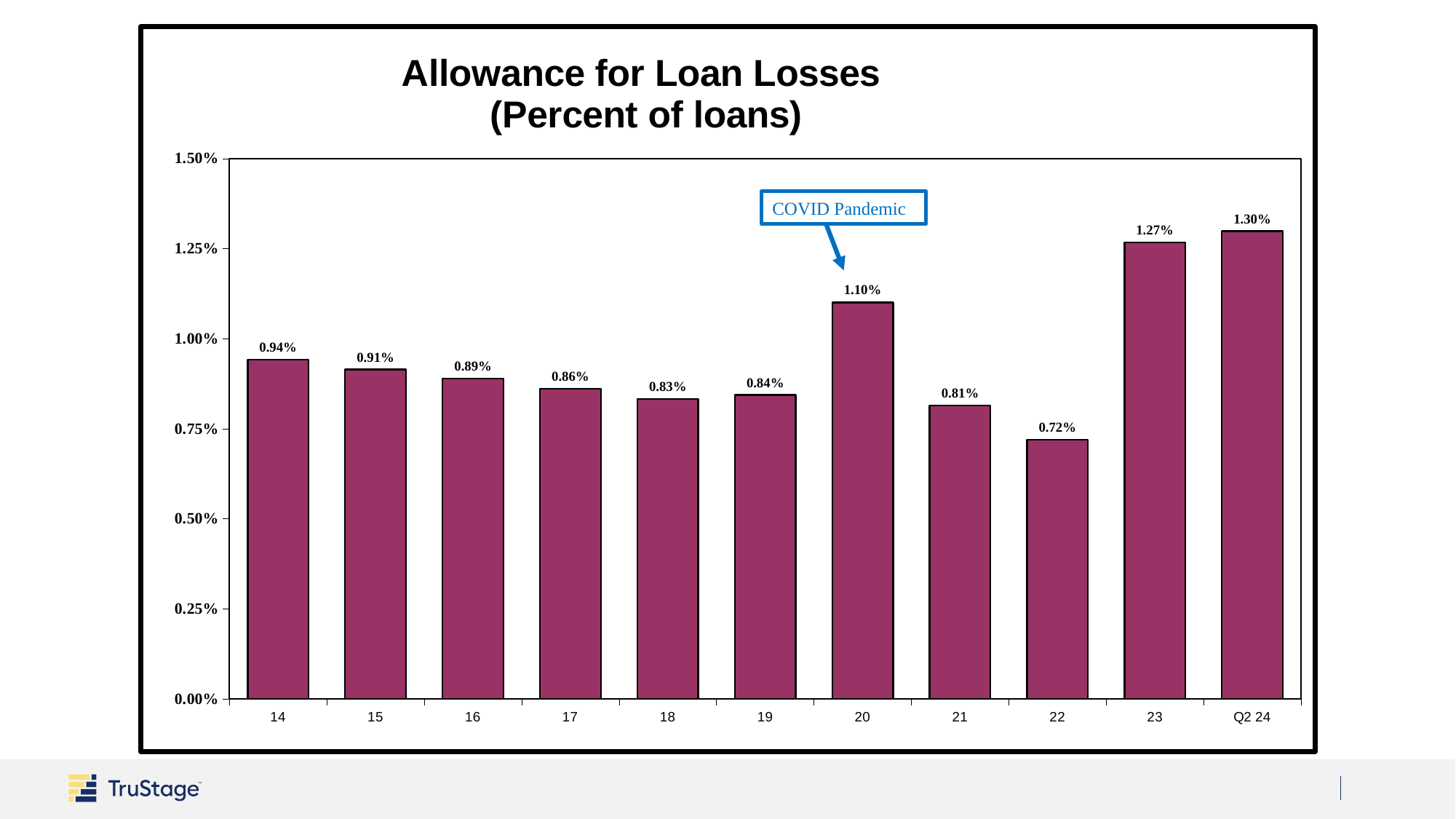
What is the difference between the values for 23 and 22? 0.55% What is the value shown for Q2 24? 1.30% How many bars are shown in the chart? 11 Is the value for 21 greater or less than 1.00%? less Which is larger, the value for 18 or the value for 19? 19 Do the values rise or fall from 14 to 18? fall What kind of chart is shown on the slide? bar chart Which year does the 'COVID Pandemic' annotation point to? 20 What is the value shown for 22? 0.72% Which year has the lowest allowance for loan losses? 22 What is the allowance for loan losses as a percent of loans in 20? 1.10% Which year has the highest allowance for loan losses? Q2 24